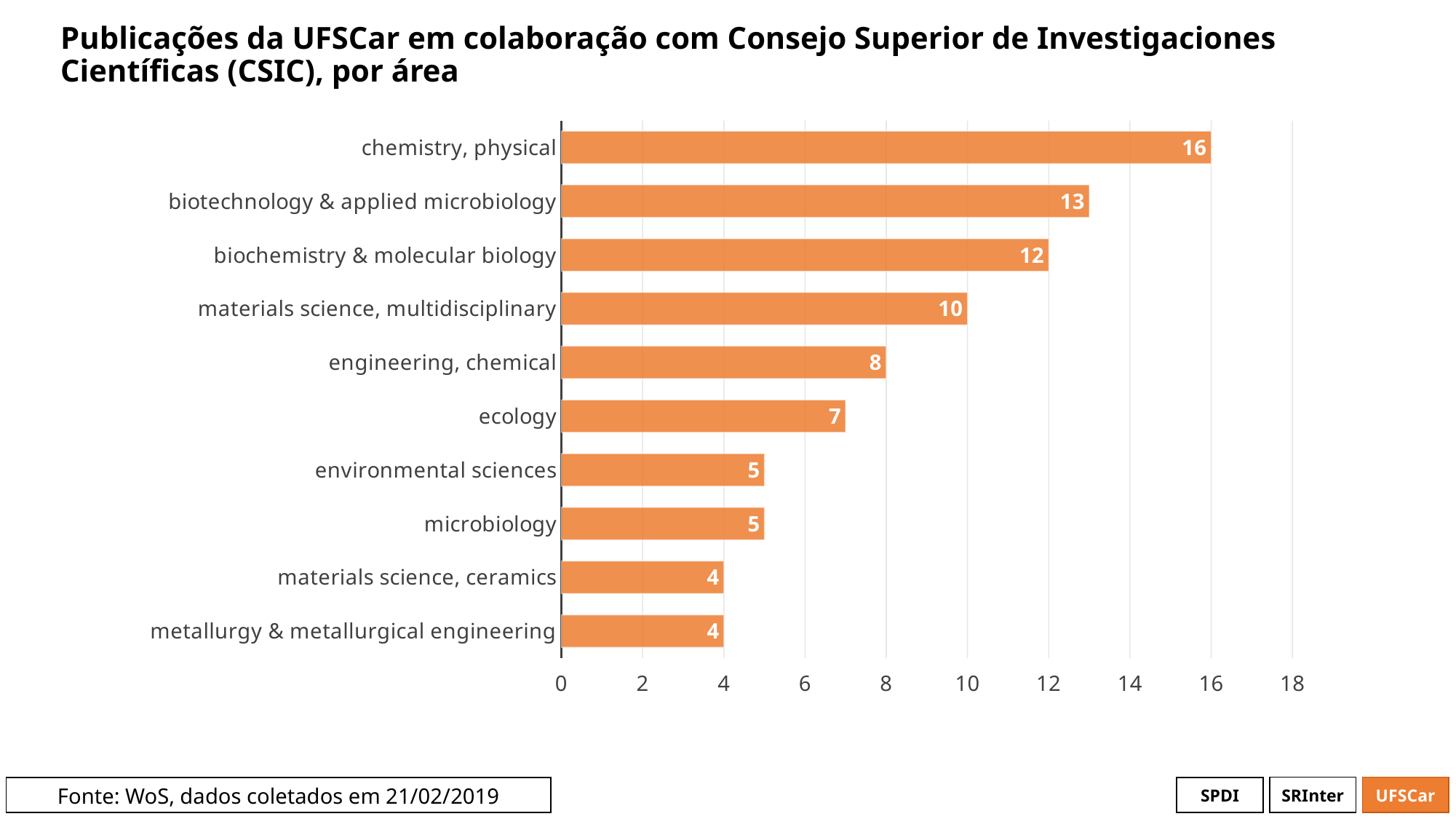
What is the difference between the values for engineering, chemical and materials science, ceramics? 4 How many areas are shown in the chart? 10 What is the value for chemistry, physical? 16 What is the source of the data cited on the slide? WoS, dados coletados em 21/02/2019 What kind of chart is shown on the slide? bar chart Is the value for biotechnology & applied microbiology greater or less than 10? greater What is the value for biotechnology & applied microbiology? 13 What is the difference between the values for chemistry, physical and biochemistry & molecular biology? 4 What is the value for environmental sciences? 5 Which is larger, the value for materials science, multidisciplinary or the value for engineering, chemical? materials science, multidisciplinary Which area has the highest value? chemistry, physical What is the value for ecology? 7